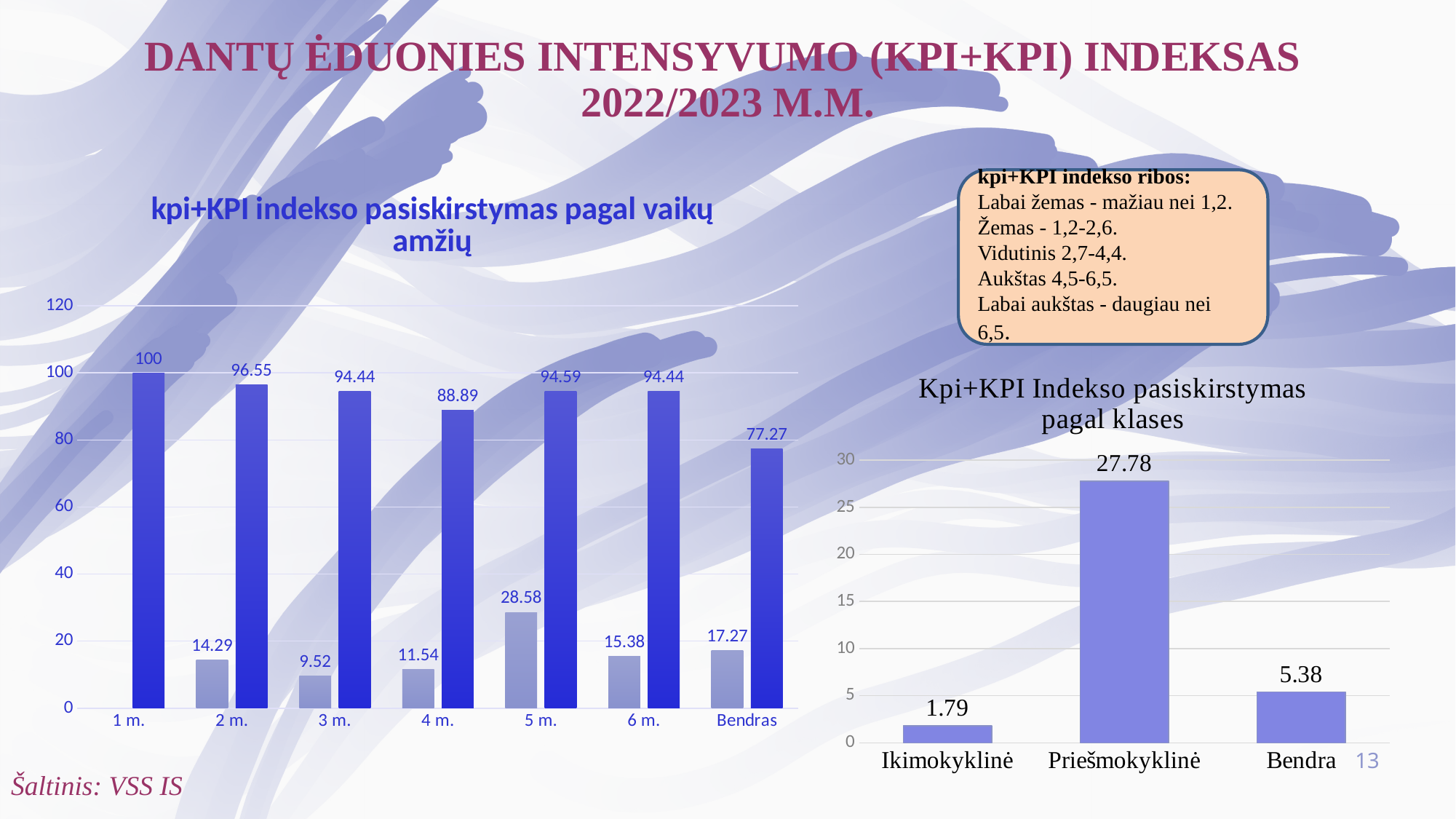
How many categories are shown in the chart 'Kpi+KPI Indekso pasiskirstymas pagal klases'? 3 In the chart 'kpi+KPI indekso pasiskirstymas pagal vaikų amžių', is the dark blue bar for Bendras greater or less than 80? less In the chart 'Kpi+KPI Indekso pasiskirstymas pagal klases', which category has the lowest value? Ikimokyklinė In the chart 'Kpi+KPI Indekso pasiskirstymas pagal klases', what is the value for Ikimokyklinė? 1.79 In the chart 'Kpi+KPI Indekso pasiskirstymas pagal klases', what is the value for Priešmokyklinė? 27.78 How many categories are shown on the x axis of the chart 'kpi+KPI indekso pasiskirstymas pagal vaikų amžių'? 7 In the chart 'kpi+KPI indekso pasiskirstymas pagal vaikų amžių', what is the value of the dark blue bar for 4 m.? 88.89 In the chart 'kpi+KPI indekso pasiskirstymas pagal vaikų amžių', which category has the highest dark blue bar? 1 m. In the chart 'Kpi+KPI Indekso pasiskirstymas pagal klases', what is the difference between the values for Priešmokyklinė and Bendra? 22.40 In the chart 'kpi+KPI indekso pasiskirstymas pagal vaikų amžių', what is the value of the light blue bar for 5 m.? 28.58 In the chart 'Kpi+KPI Indekso pasiskirstymas pagal klases', which category has the highest value? Priešmokyklinė What type of chart is 'kpi+KPI indekso pasiskirstymas pagal vaikų amžių'? bar chart